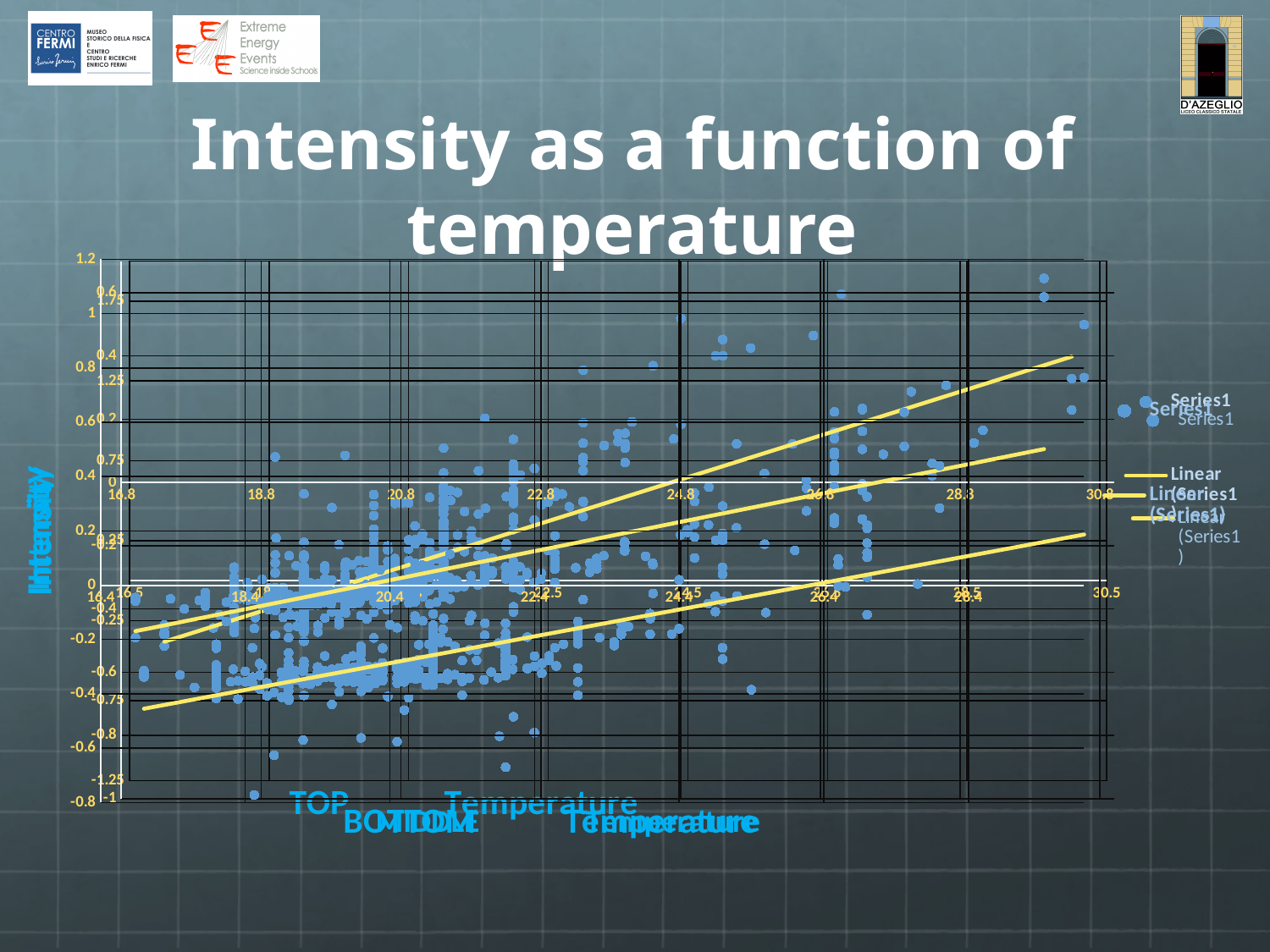
Do the fitted trend lines rise or fall as temperature increases along the x axis? rise How many entries does the chart legend list? 2 What kind of chart is shown on the slide? scatter chart